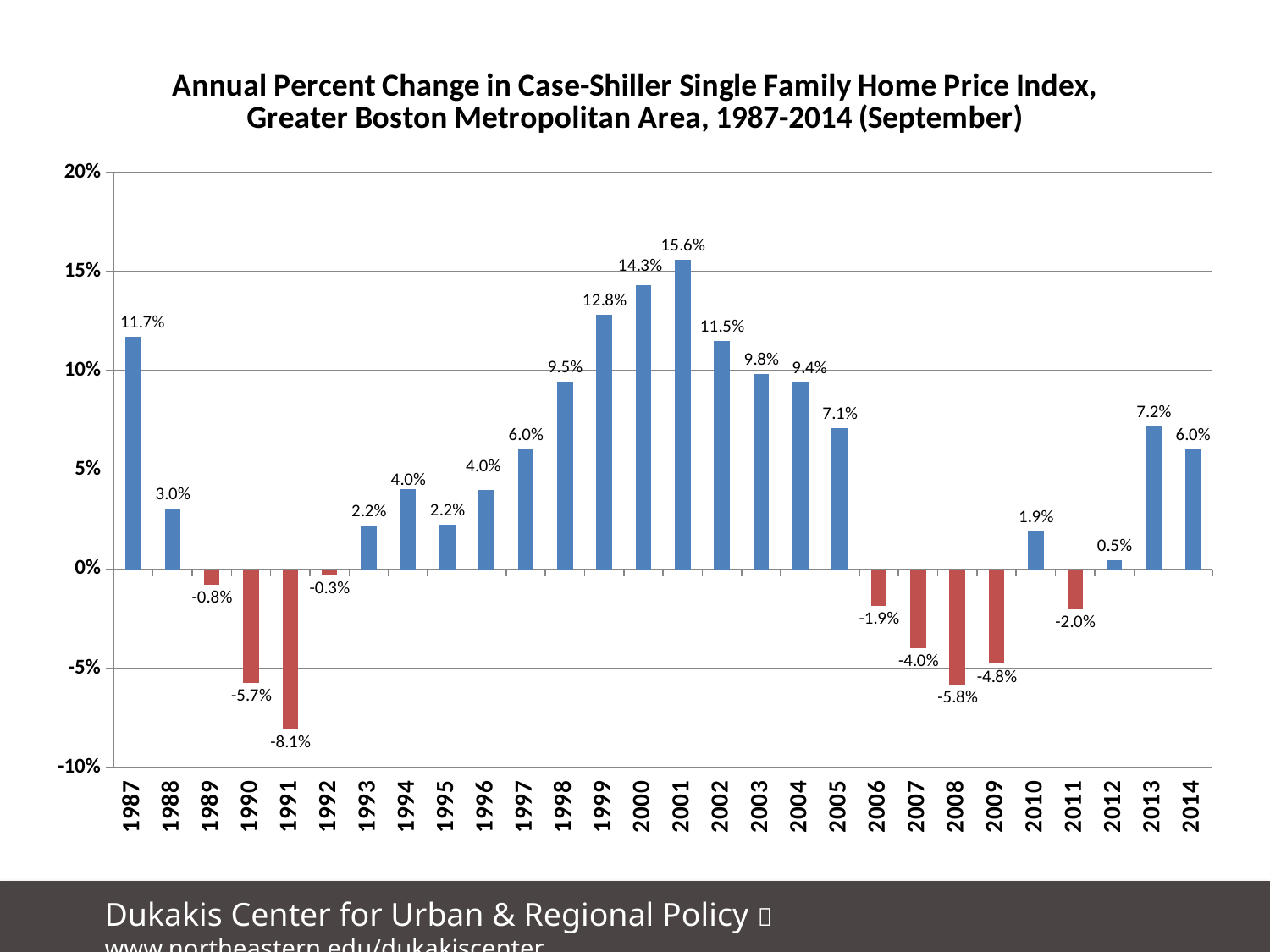
What kind of chart is shown on the slide? Bar chart What is the annual percent change shown for 2001? 15.6% Is the value for 1987 greater or less than 10%? greater Which year has the lowest annual percent change? 1991 What is the annual percent change shown for 2014? 6.0% How many years are shown on the x axis? 28 Do the values rise or fall from 1996 to 2001? Rise Which year has the larger value, 2013 or 2010? 2013 What is the difference between the values for 2000 and 1999? 1.5% What is the annual percent change shown for 1991? -8.1% What colour are the bars for years with negative values? Red Which year has the highest annual percent change? 2001